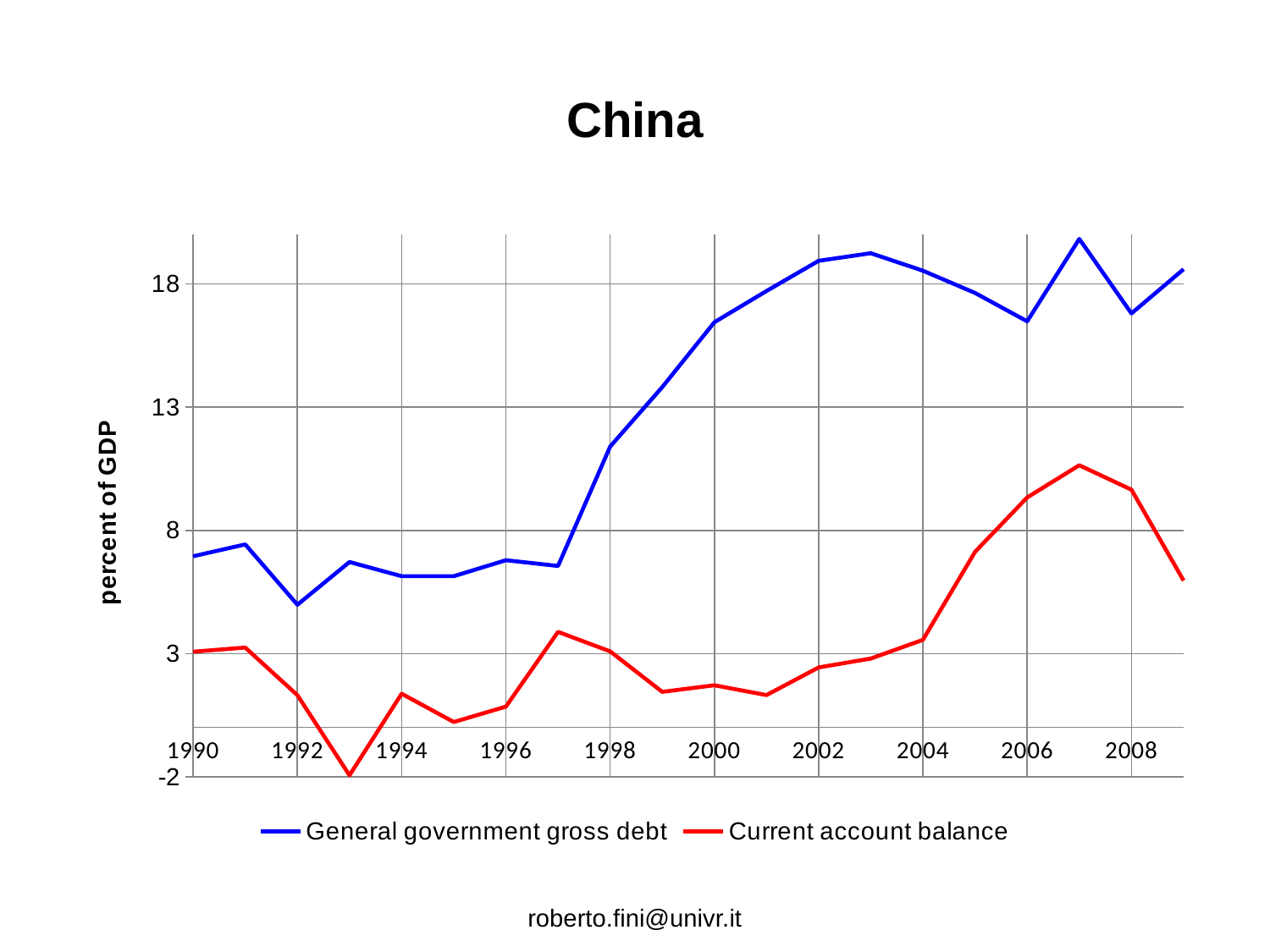
Does General government gross debt rise or fall between 1997 and 2003? rise Is the value for General government gross debt in 2003 greater or less than 18? greater In which year is General government gross debt at its lowest? 1992 In 2000, which series has the larger value, General government gross debt or Current account balance? General government gross debt What is the title of the chart? China What kind of chart is shown on the slide? line chart Is the value for General government gross debt in 1998 greater or less than 13? less In which year is the Current account balance at its lowest? 1993 How many series does the legend list? 2 In which year is the Current account balance at its highest? 2007 What is the label on the vertical axis? percent of GDP Is the value for Current account balance in 2007 greater or less than 8? greater